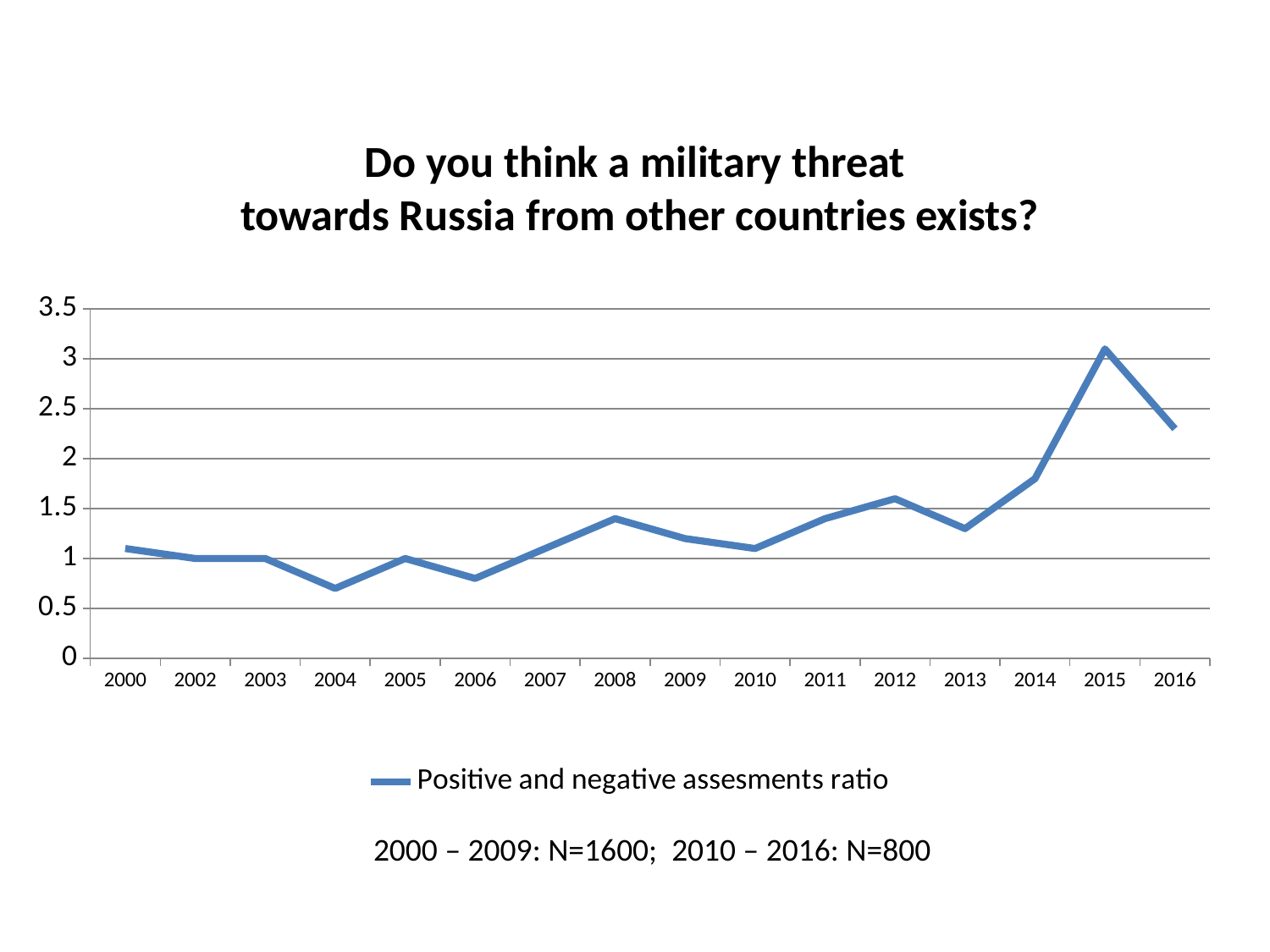
Is the value for 2016 greater or less than 2? greater Is the value for 2004 greater or less than 1? less How many series does the legend list? 1 Does the value rise or fall from 2013 to 2015? rise Is the value for 2008 greater or less than 1.5? less Which year has the lowest positive and negative assessments ratio? 2004 What is the name of the series shown in the legend? Positive and negative assesments ratio Which year has the highest positive and negative assessments ratio? 2015 Which year has a larger value, 2015 or 2016? 2015 How many years are plotted on the x axis? 16 What kind of chart is shown on the slide? line chart